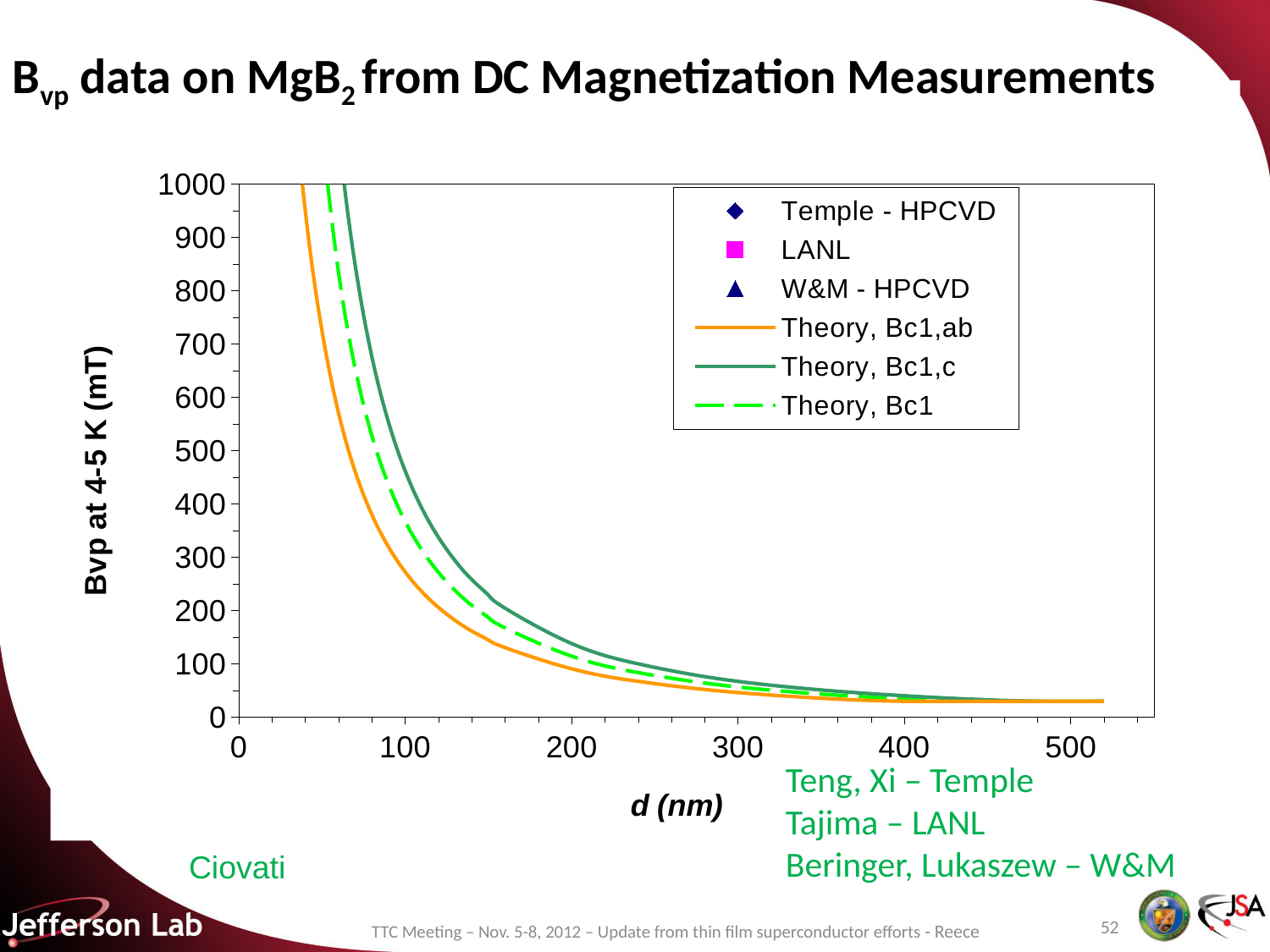
Which legend entry is drawn as a dashed line? Theory, Bc1 What kind of chart is shown on the slide? line chart How many series does the legend list? 6 Which theory curve lies highest across the plotted range? Theory, Bc1,c Is the value of Theory, Bc1,ab at d = 100 nm greater or less than 500? less What is the label of the y axis? Bvp at 4-5 K (mT) Is the value of Theory, Bc1,ab at d = 300 nm greater or less than 100? less Which theory curve lies lowest across the plotted range? Theory, Bc1,ab At d = 100 nm, which is larger: Theory, Bc1,ab or Theory, Bc1,c? Theory, Bc1,c Do the theory curves rise or fall as d (nm) increases? fall Is the value of Theory, Bc1,c at d = 100 nm greater or less than 300? greater